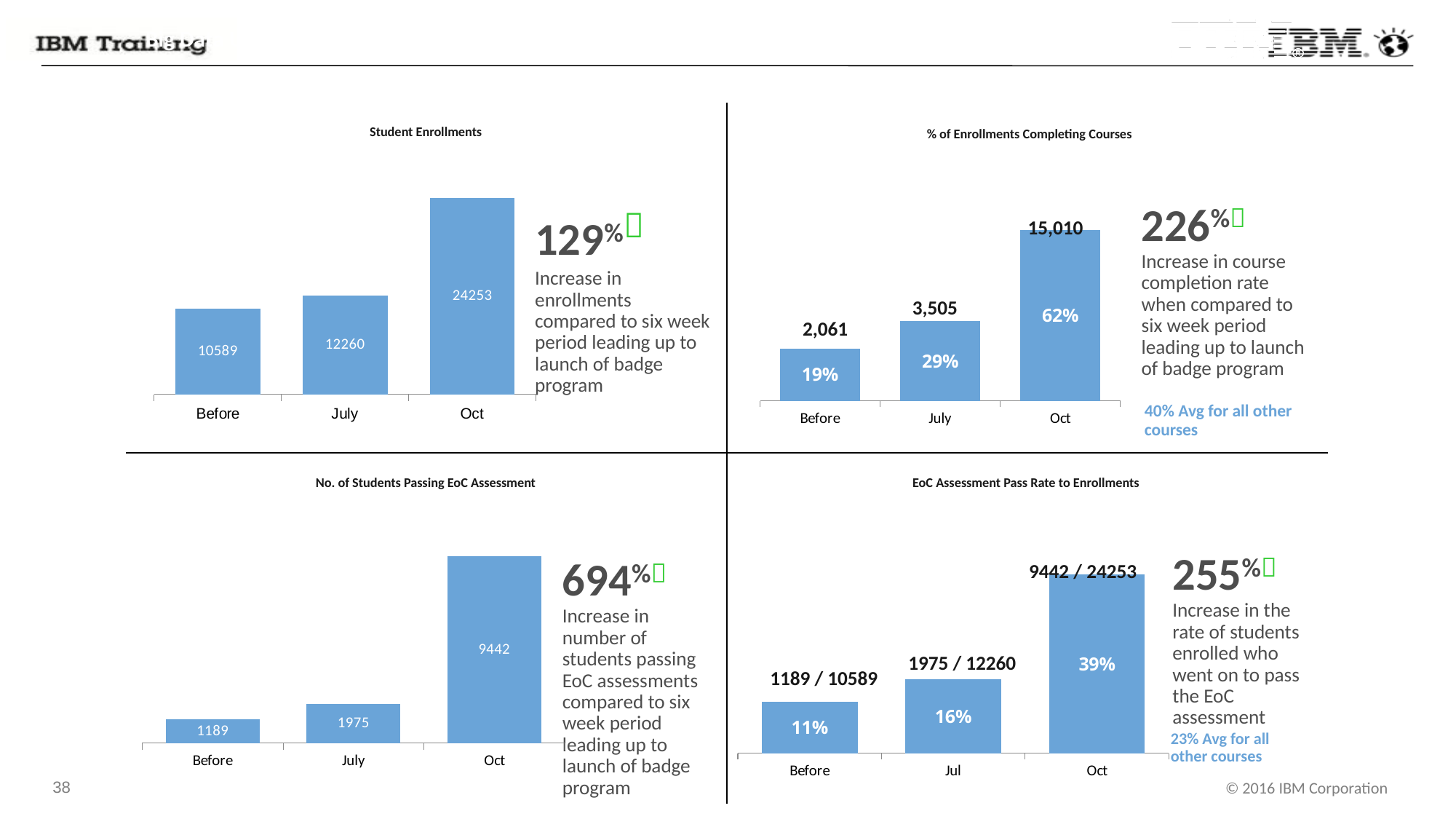
In the 'EoC Assessment Pass Rate to Enrollments' chart, what percentage is shown for Oct? 39% In the 'Student Enrollments' chart, what is the difference between the Oct and July values? 11993 What type of chart is the 'Student Enrollments' chart? Bar chart In the 'No. of Students Passing EoC Assessment' chart, what is the value for July? 1975 In the '% of Enrollments Completing Courses' chart, what percentage is shown for July? 29% In the '% of Enrollments Completing Courses' chart, which category has the highest value? Oct In the 'EoC Assessment Pass Rate to Enrollments' chart, how many categories are plotted? 3 In the '% of Enrollments Completing Courses' chart, what count is printed above the Oct bar? 15,010 In the 'No. of Students Passing EoC Assessment' chart, what is the difference between the Oct and Before values? 8253 In the 'No. of Students Passing EoC Assessment' chart, which category has the lowest value? Before In the 'Student Enrollments' chart, what is the value for Before? 10589 In the 'Student Enrollments' chart, what is the value for Oct? 24253